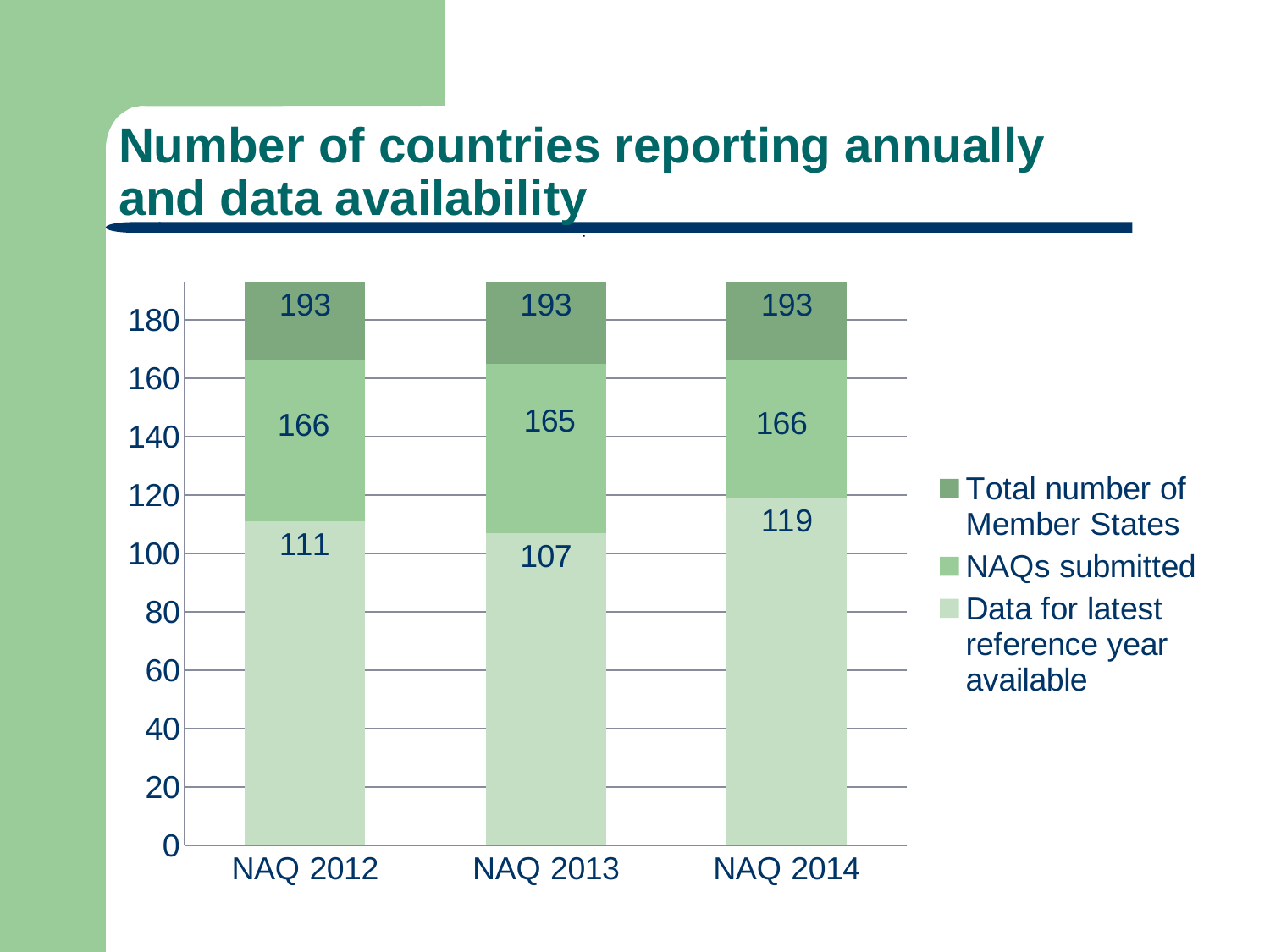
Is the value for Data for latest reference year available in NAQ 2012 larger than in NAQ 2013? Yes What is the difference between the Total number of Member States and NAQs submitted in NAQ 2012? 27 What is the difference between the Data for latest reference year available values for NAQ 2014 and NAQ 2013? 12 What is the value for Data for latest reference year available in NAQ 2014? 119 Which year has the lowest value for Data for latest reference year available? NAQ 2013 How many series does the legend list? 3 What is the value for NAQs submitted in NAQ 2013? 165 What is the value for Data for latest reference year available in NAQ 2012? 111 What kind of chart is shown on the slide? Bar chart How many years are shown on the x axis? 3 Which year has the highest value for Data for latest reference year available? NAQ 2014 What is the value for Total number of Member States in NAQ 2012? 193